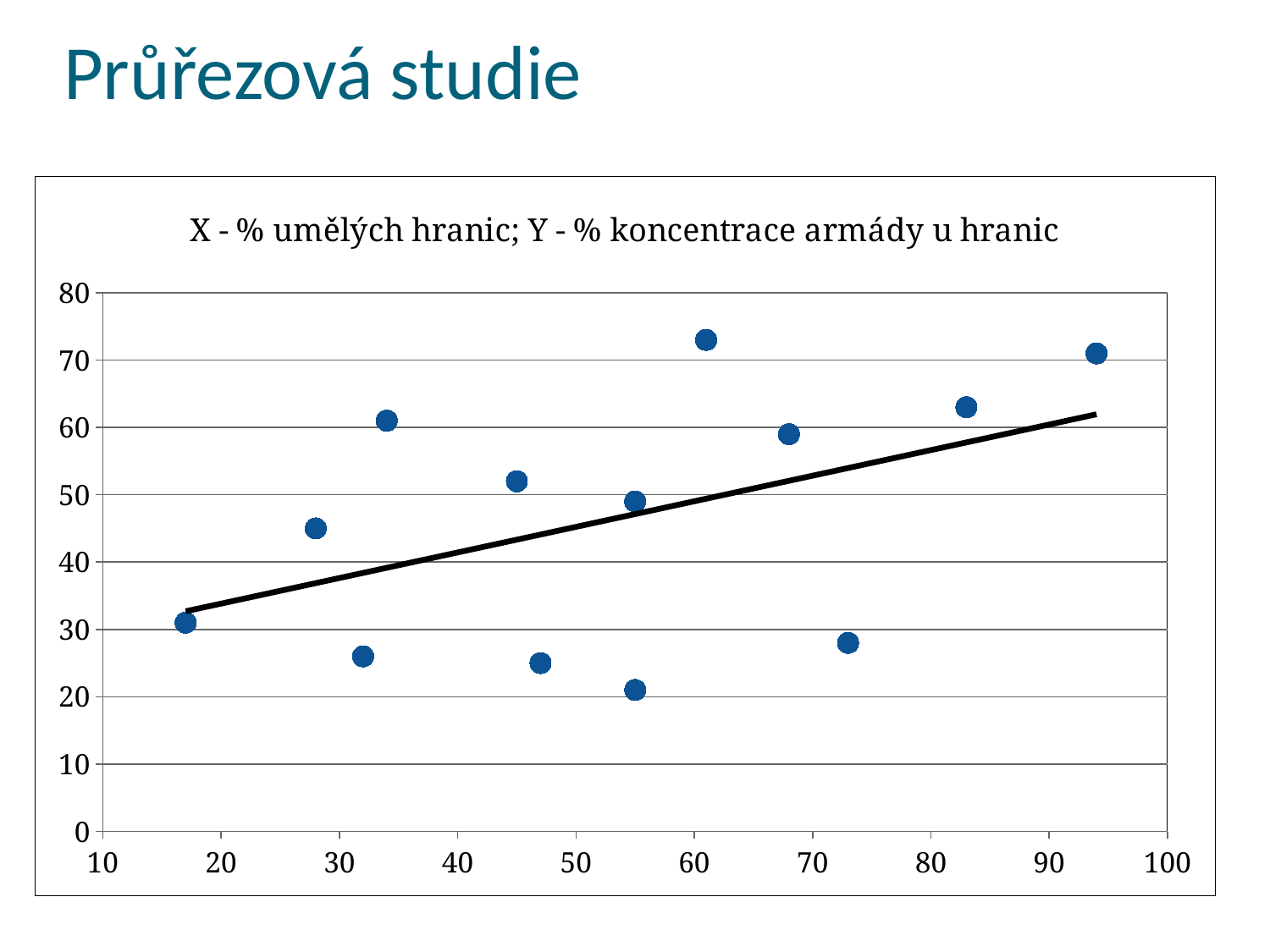
Is the y value of the point with the smallest x value (near x = 17) greater or less than 40? less Is the y value of the highest plotted point greater or less than 70? greater Is the y value of the point near x = 73 greater or less than 40? less Which has the higher y value: the point near x = 61 or the point near x = 68? the point near x = 61 Does the trend line on the chart rise or fall as the x value increases? rises How many data points are plotted on the chart? 13 What kind of chart is shown on the slide? scatter chart What is the title of the chart? X - % umělých hranic; Y - % koncentrace armády u hranic What is the highest value shown on the y axis of the chart? 80